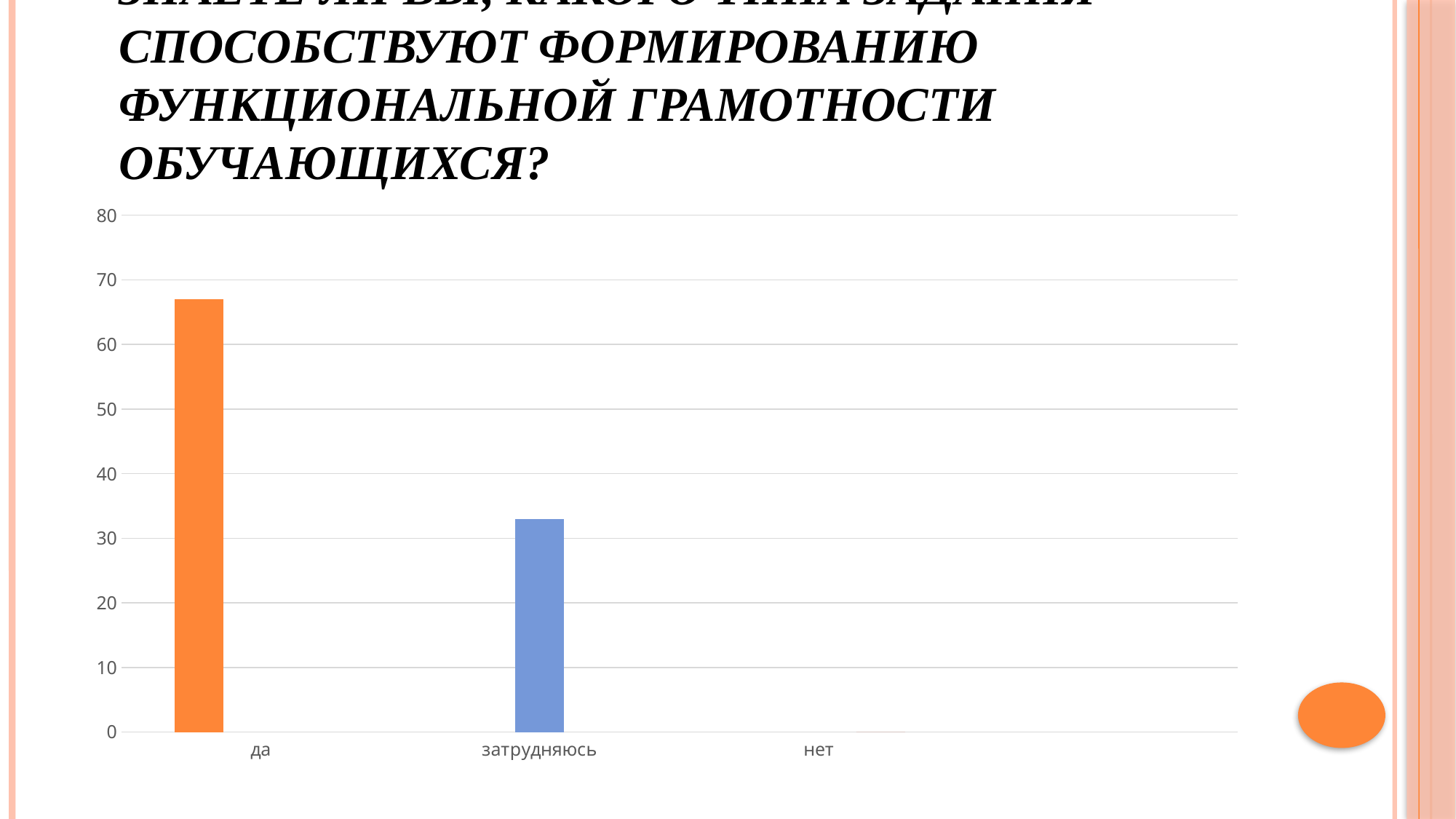
What kind of chart is shown on the slide? bar chart Do the values rise or fall moving from left to right along the x axis? fall Is the value for затрудняюсь greater or less than 40? less Is the value for да greater or less than 60? greater What colour is the bar for затрудняюсь? blue Which is larger, the value for да or the value for затрудняюсь? да Is the value for затрудняюсь greater or less than 30? greater How many categories are shown on the x axis of the chart? 3 Which category has the highest bar in the chart? да Which category has the lowest value in the chart? нет What colour is the bar for да? orange